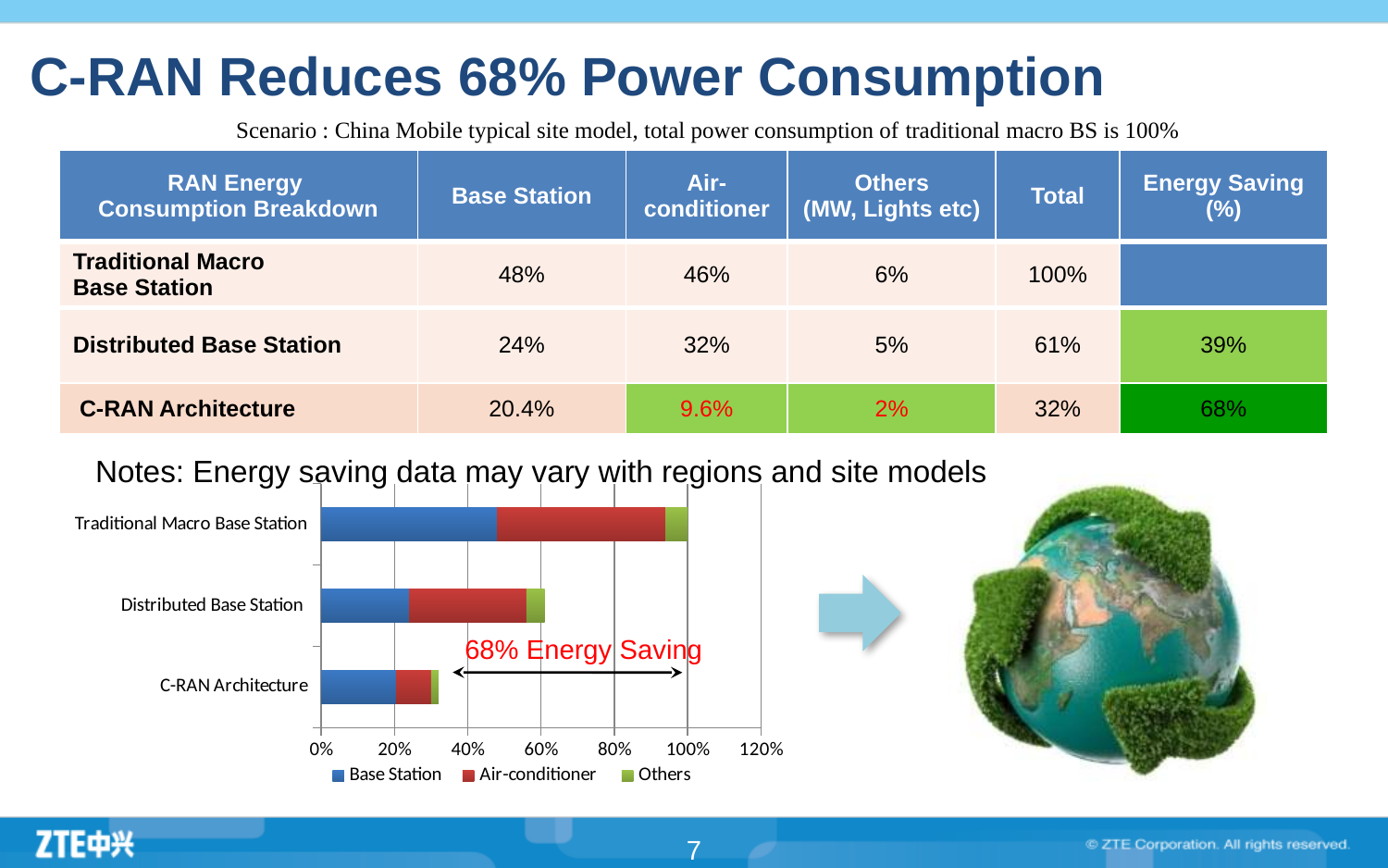
Is the Base Station segment for Traditional Macro Base Station greater or less than 40%? greater What text is annotated in red on the chart between the Distributed Base Station and C-RAN Architecture bars? 68% Energy Saving Which category has the shortest total bar in the chart? C-RAN Architecture Is the total bar for Distributed Base Station greater or less than 80%? less How many categories (base station types) are plotted in the bar chart? 3 What colour represents the Others series in the chart legend? green How many series does the chart legend list? 3 Which category has the longest total bar in the chart? Traditional Macro Base Station What is the total of the stacked bar for Traditional Macro Base Station? 100% What kind of chart is shown on the slide? bar chart Is the total bar for C-RAN Architecture greater or less than 40%? less For Distributed Base Station, which segment is larger: Base Station or Air-conditioner? Air-conditioner